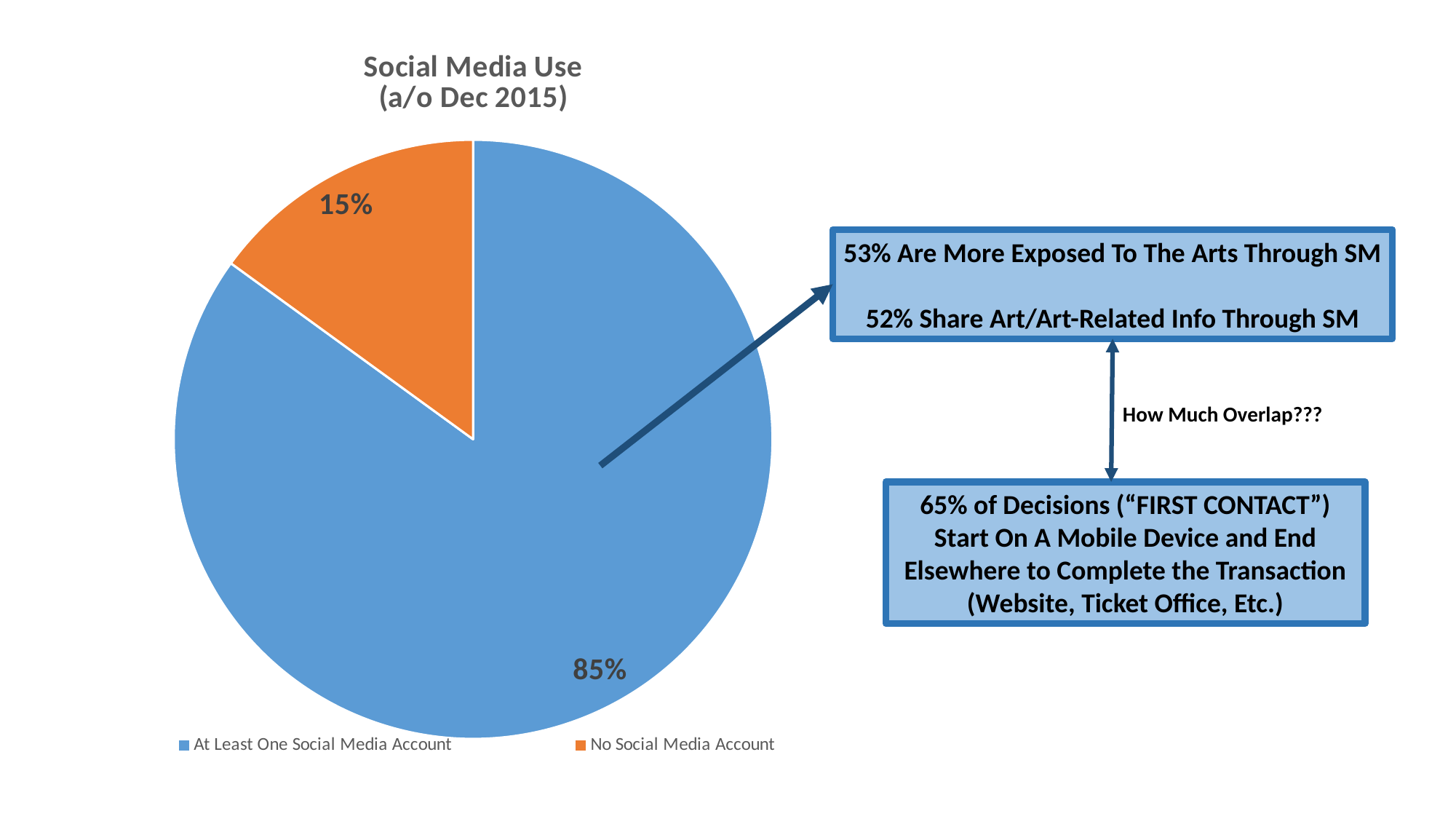
What percentage of the pie is labelled "At Least One Social Media Account"? 85% Which slice of the pie is the largest? At Least One Social Media Account How many entries does the legend list? 2 What colour is the "No Social Media Account" slice? orange Which is larger: the "At Least One Social Media Account" slice or the "No Social Media Account" slice? At Least One Social Media Account Which slice of the pie is the smallest? No Social Media Account What percentage of the pie is labelled "No Social Media Account"? 15% What is the title of the chart? Social Media Use (a/o Dec 2015) What kind of chart is shown on the slide? pie chart What share of the pie does the "No Social Media Account" slice represent? 15% What is the difference in percentage points between the "At Least One Social Media Account" slice and the "No Social Media Account" slice? 70 How many slices does the pie chart have? 2